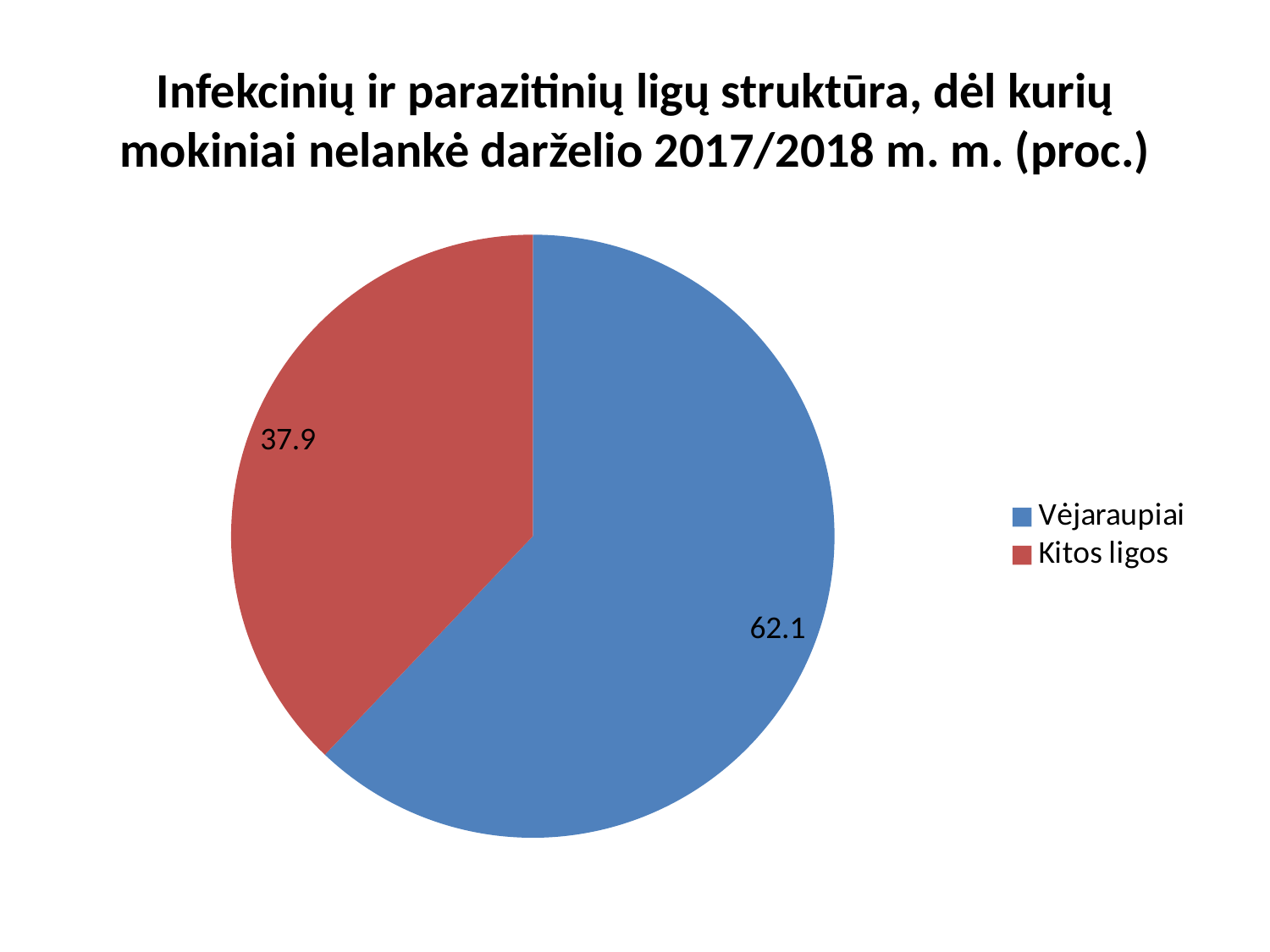
What colour is the slice for Kitos ligos? red Which is larger, Vėjaraupiai or Kitos ligos? Vėjaraupiai What is the value for Vėjaraupiai? 62.1 Which category has the smallest slice? Kitos ligos What is the difference between the values for Vėjaraupiai and Kitos ligos? 24.2 How many slices does the pie chart have? 2 What colour is the slice for Vėjaraupiai? blue What kind of chart is shown on the slide? pie chart How many entries does the legend list? 2 Which category has the largest slice? Vėjaraupiai What is the value for Kitos ligos? 37.9 What share of the pie does Kitos ligos represent? 37.9